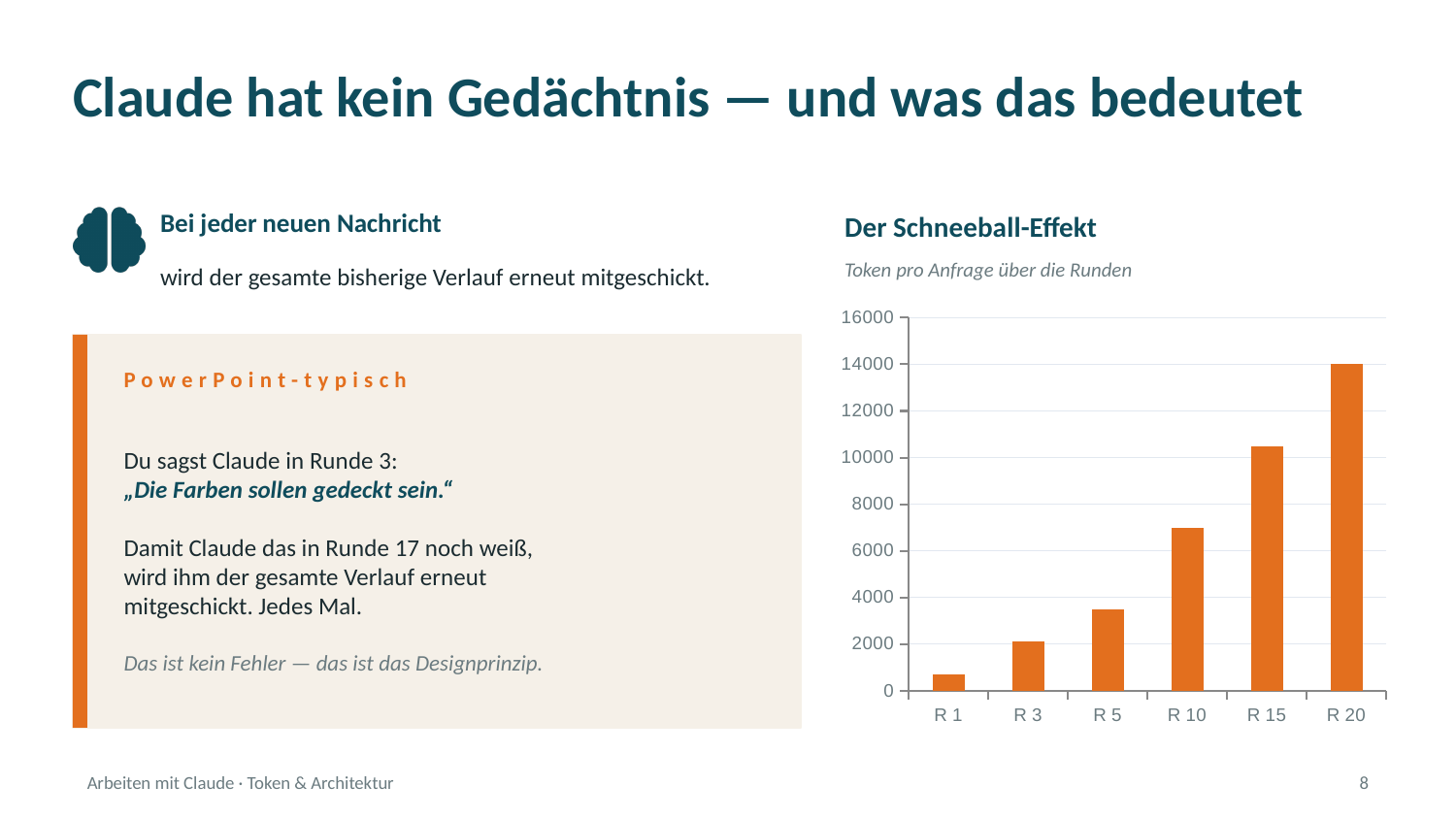
Is the value for R 20 greater or less than 12000? greater Do the values rise or fall from R 1 to R 20 along the x axis? rise What is the subtitle shown under the chart title? Token pro Anfrage über die Runden Which category has the lowest value in the chart? R 1 Is the value for R 1 greater or less than 2000? less What is the title of the chart? Der Schneeball-Effekt Is the value for R 5 greater or less than 4000? less What kind of chart is shown under "Der Schneeball-Effekt"? bar chart Which category has the highest value in the chart? R 20 How many bars (categories) does the chart show? 6 Which is larger, the value for R 10 or the value for R 5? R 10